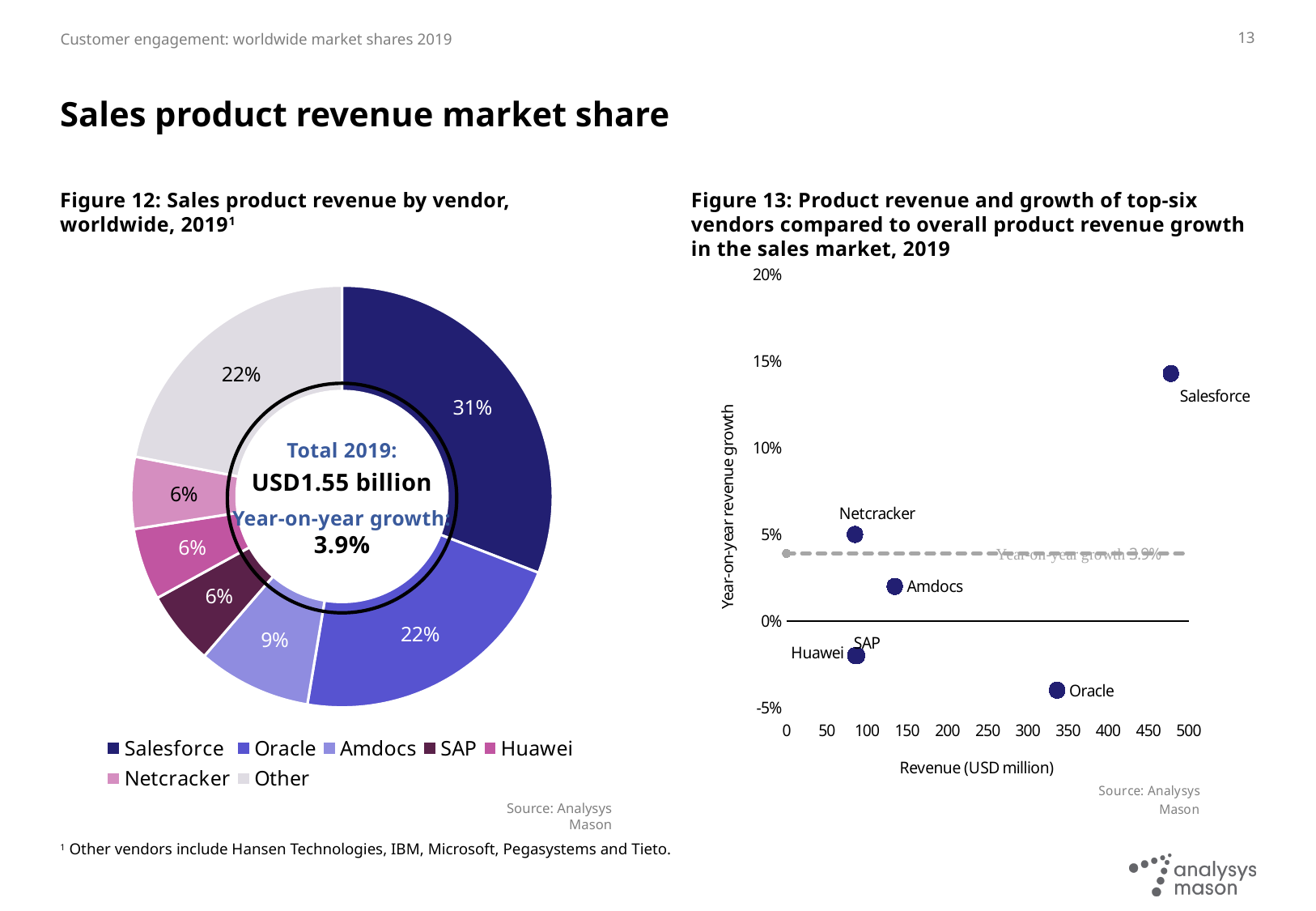
In Figure 12, which vendor has the largest share of sales product revenue? Salesforce In Figure 12, how many entries does the legend list? 7 In Figure 13, which vendor has the highest year-on-year revenue growth? Salesforce In Figure 12, what share of sales product revenue does Salesforce hold? 31% In Figure 12, how many percentage points larger is Salesforce's share than Oracle's share? 9 percentage points In Figure 13, is Salesforce's revenue greater or less than 400 USD million? greater In Figure 12, what share of sales product revenue does Amdocs hold? 9% What kind of chart is Figure 12? Pie (donut) chart What kind of chart is Figure 13? Scatter chart In Figure 12, what is the total 2019 sales product revenue shown in the centre of the chart? USD1.55 billion In Figure 13, which vendor has the lowest year-on-year revenue growth? Oracle In Figure 13, which vendor has higher year-on-year revenue growth, Netcracker or Amdocs? Netcracker